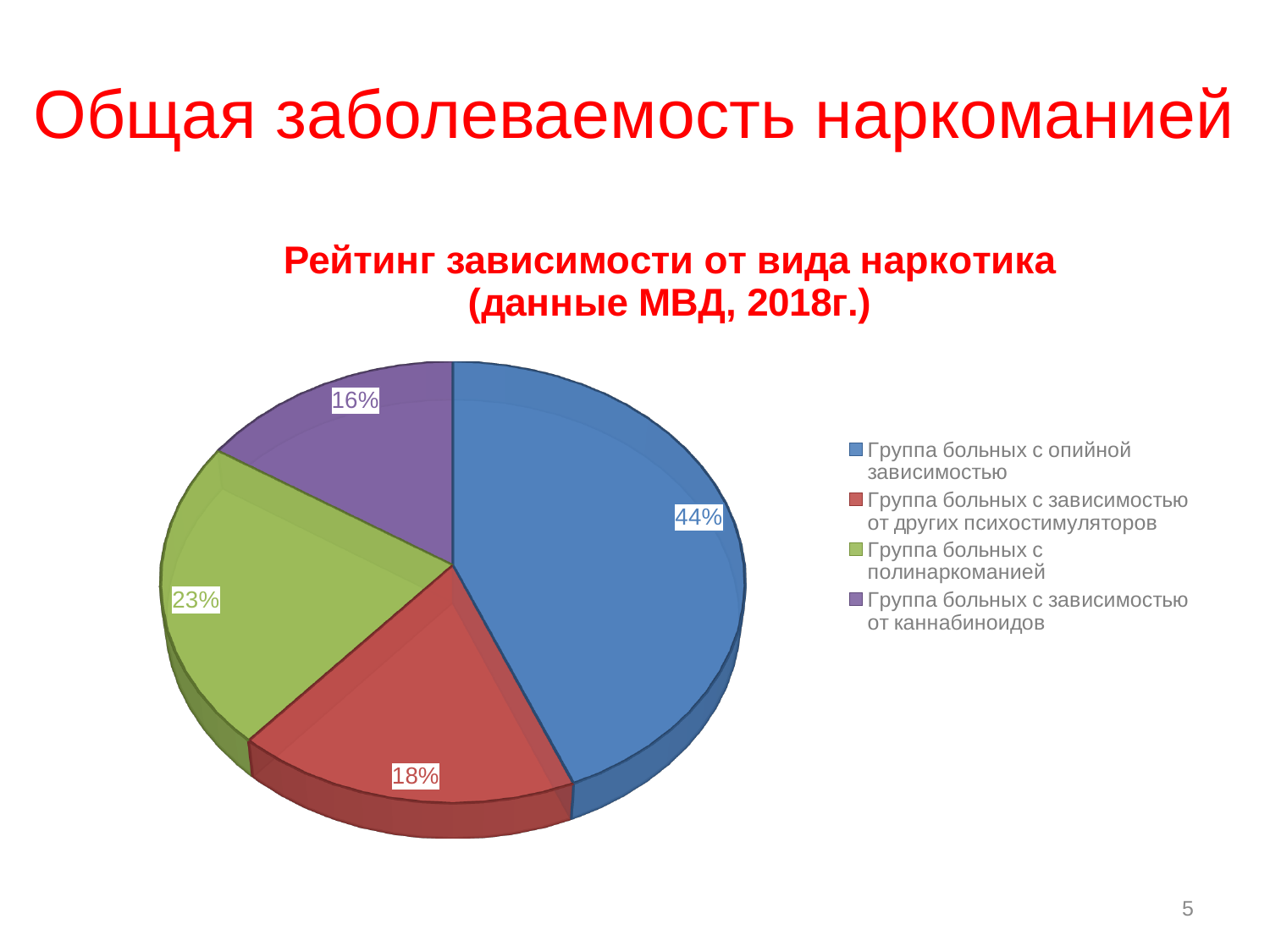
Which is larger: the share for the polydrug addiction group or the share for the other psychostimulants group? Группа больных с полинаркоманией What kind of chart is shown on the slide? Pie chart Which group has the largest slice of the pie? Группа больных с опийной зависимостью What is the difference in percentage points between the opioid dependence group and the polydrug addiction group? 21 What colour is the slice for the group of patients with polydrug addiction (Группа больных с полинаркоманией)? Green What share of the pie is the group of patients with polydrug addiction (Группа больных с полинаркоманией)? 23% Which group has the smallest slice of the pie? Группа больных с зависимостью от каннабиноидов What share of the pie is the group of patients with cannabinoid dependence (Группа больных с зависимостью от каннабиноидов)? 16% What is the title of the chart? Рейтинг зависимости от вида наркотика (данные МВД, 2018г.) How many slices does the pie chart have? 4 What share of the pie is the group of patients with opioid dependence (Группа больных с опийной зависимостью)? 44% What share of the pie is the group of patients with dependence on other psychostimulants (Группа больных с зависимостью от других психостимуляторов)? 18%